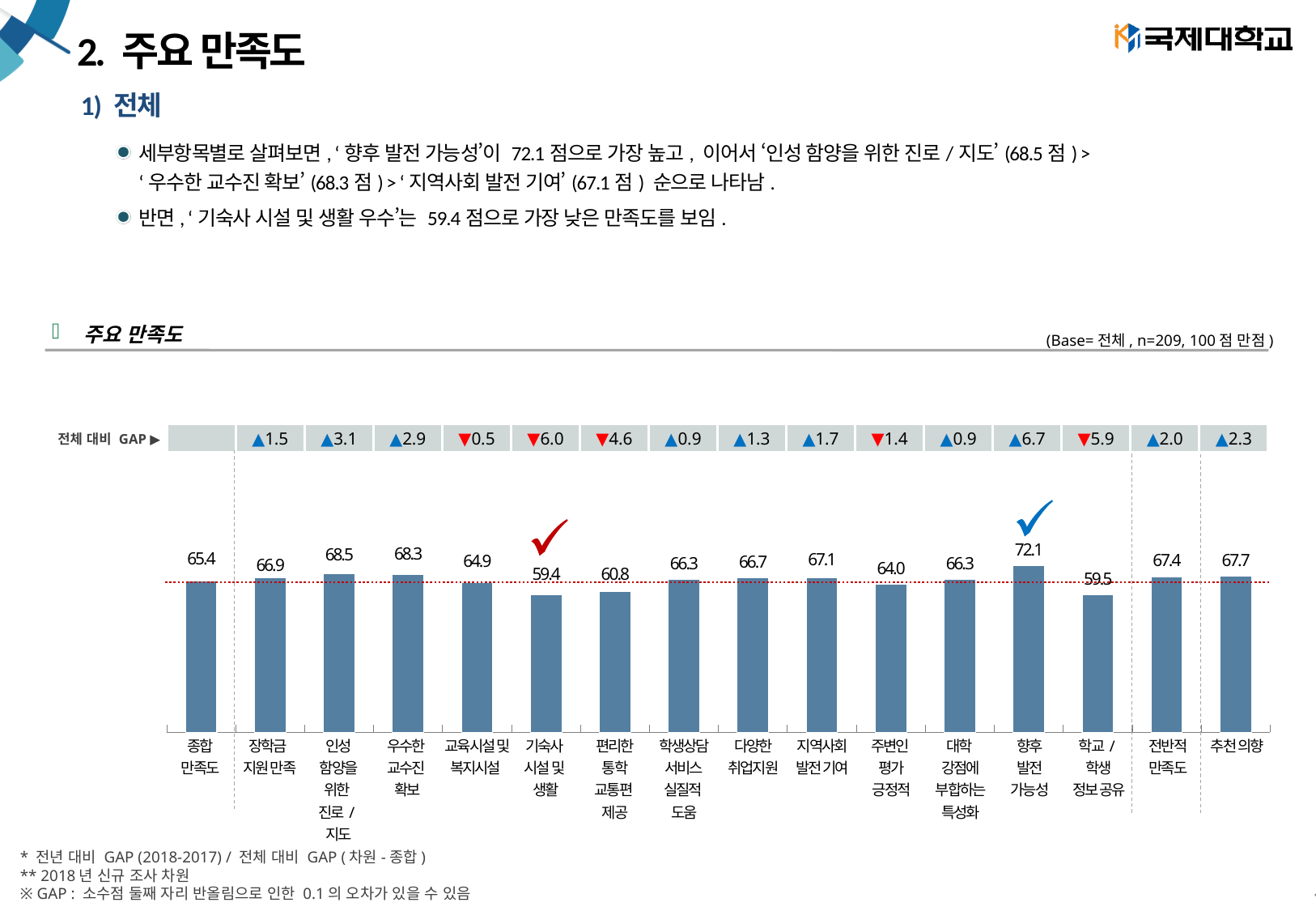
What is the value for 기숙사 시설 및 생활? 59.4 Which category has the highest value? 향후 발전 가능성 What is the value for 추천의향? 67.7 What is the difference between 인성 함양을 위한 진로/지도 and 우수한 교수진 확보? 0.2 What kind of chart is shown? bar chart What is the value for 종합 만족도? 65.4 Which category has the lowest value? 기숙사 시설 및 생활 Which is larger, 장학금 지원만족 or 편리한 통학 교통편 제공? 장학금 지원만족 What is the 전체 대비 GAP value shown above 향후 발전 가능성? ▲6.7 What is the difference between 향후 발전 가능성 and 기숙사 시설 및 생활? 12.7 What is the value for 향후 발전 가능성? 72.1 How many categories are plotted in the chart? 16